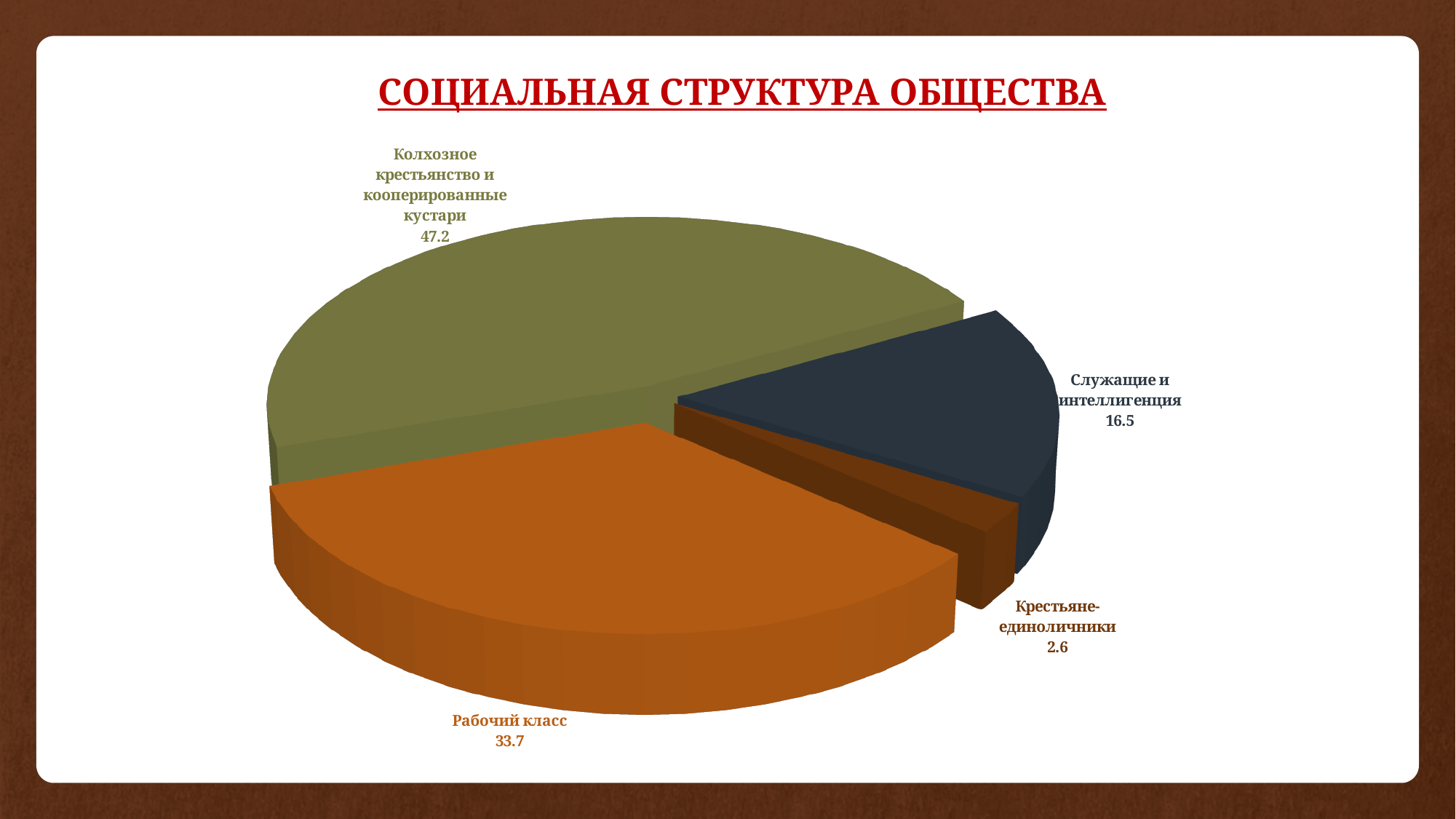
What kind of chart is shown on the slide? pie chart What is the difference between the values for Служащие и интеллигенция and Крестьяне-единоличники? 13.9 What is the difference between the values for Колхозное крестьянство и кооперированные кустари and Рабочий класс? 13.5 What is the value for Служащие и интеллигенция? 16.5 What is the value for Рабочий класс? 33.7 What is the value for Крестьяне-единоличники? 2.6 What is the title of the slide? СОЦИАЛЬНАЯ СТРУКТУРА ОБЩЕСТВА What is the value for Колхозное крестьянство и кооперированные кустари? 47.2 Which category has the largest slice? Колхозное крестьянство и кооперированные кустари Which is larger, the value for Рабочий класс or the value for Служащие и интеллигенция? Рабочий класс Which category has the smallest slice? Крестьяне-единоличники How many categories does the pie chart show? 4